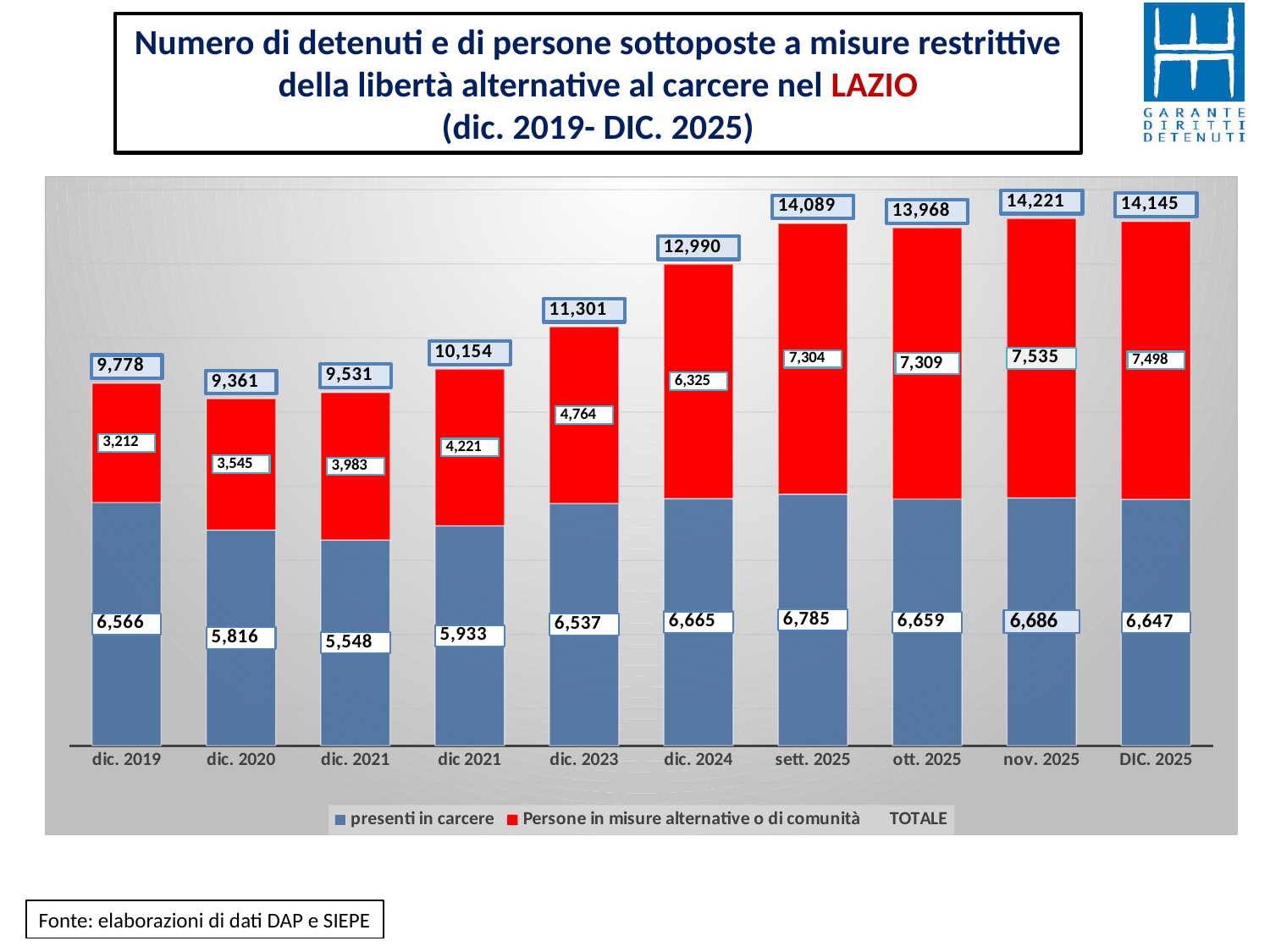
How many bars (time periods) are shown on the x axis? 10 What is the TOTALE value for nov. 2025? 14,221 Which period has the lowest TOTALE value? dic. 2020 Which period has the highest TOTALE value? nov. 2025 Does the TOTALE value generally rise or fall from dic. 2020 to nov. 2025? rise How many series does the legend list? 3 What is the value of 'Persone in misure alternative o di comunità' for dic. 2024? 6,325 What is the total of the stacked bar for dic. 2023? 11,301 What kind of chart is shown on the slide? stacked bar chart Which is larger for sett. 2025: 'presenti in carcere' or 'Persone in misure alternative o di comunità'? Persone in misure alternative o di comunità What is the value of 'presenti in carcere' for dic. 2019? 6,566 What is the difference between the TOTALE values for DIC. 2025 and dic. 2019? 4,367